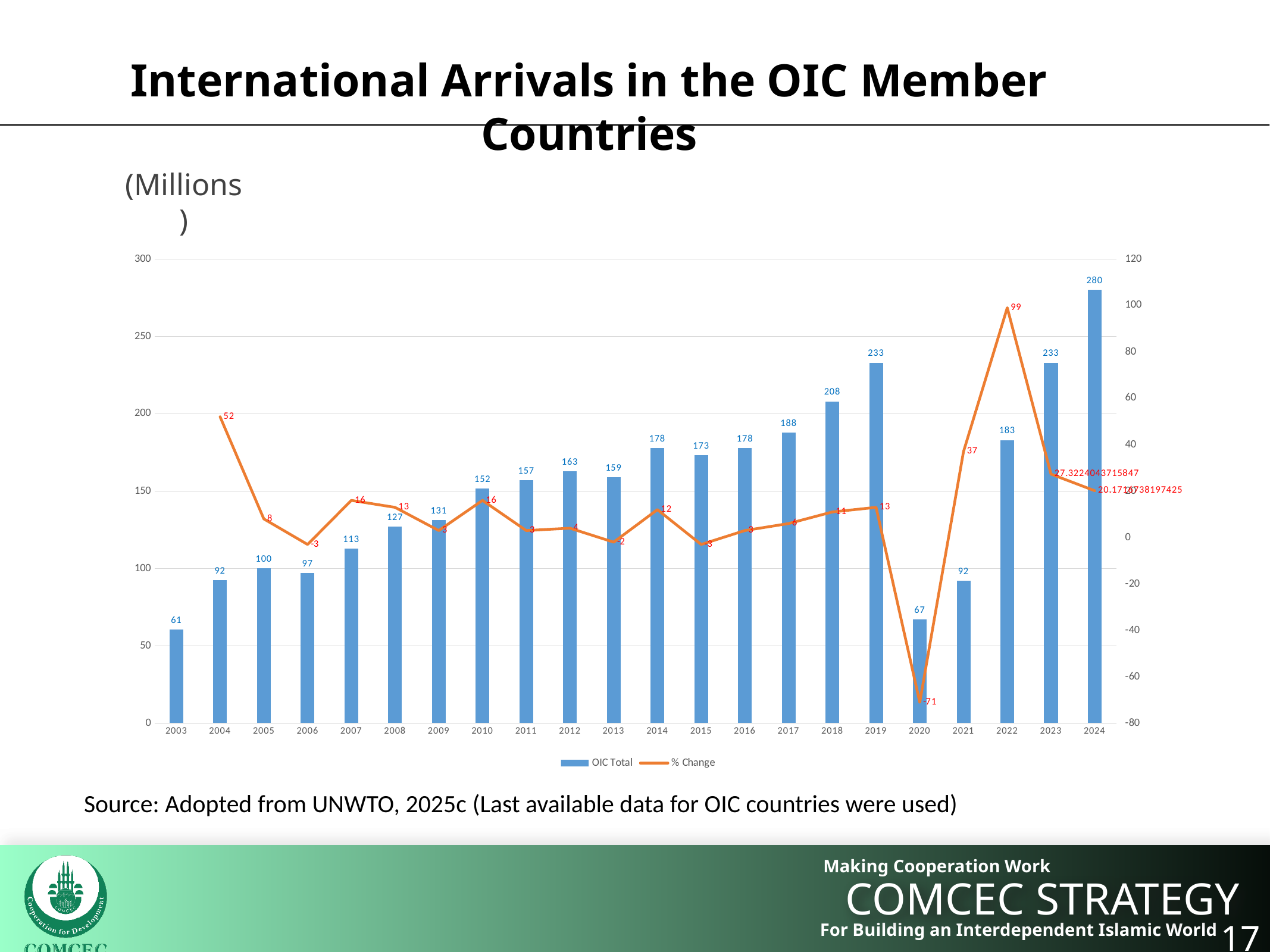
What is the difference between the OIC Total for 2019 and 2020? 166 What is the OIC Total value for 2003? 61 Which year has the highest OIC Total? 2024 What is the OIC Total value for 2024? 280 How many years are shown on the x axis? 22 What is the % Change value for 2020? -71 How many series does the legend list? 2 Which year has the lowest OIC Total? 2003 What is the % Change value for 2022? 99 Does the OIC Total rise or fall from 2020 to 2024? Rise What kind of chart is used for the OIC Total series? Bar chart Which is larger, the OIC Total for 2018 or for 2022? 2018